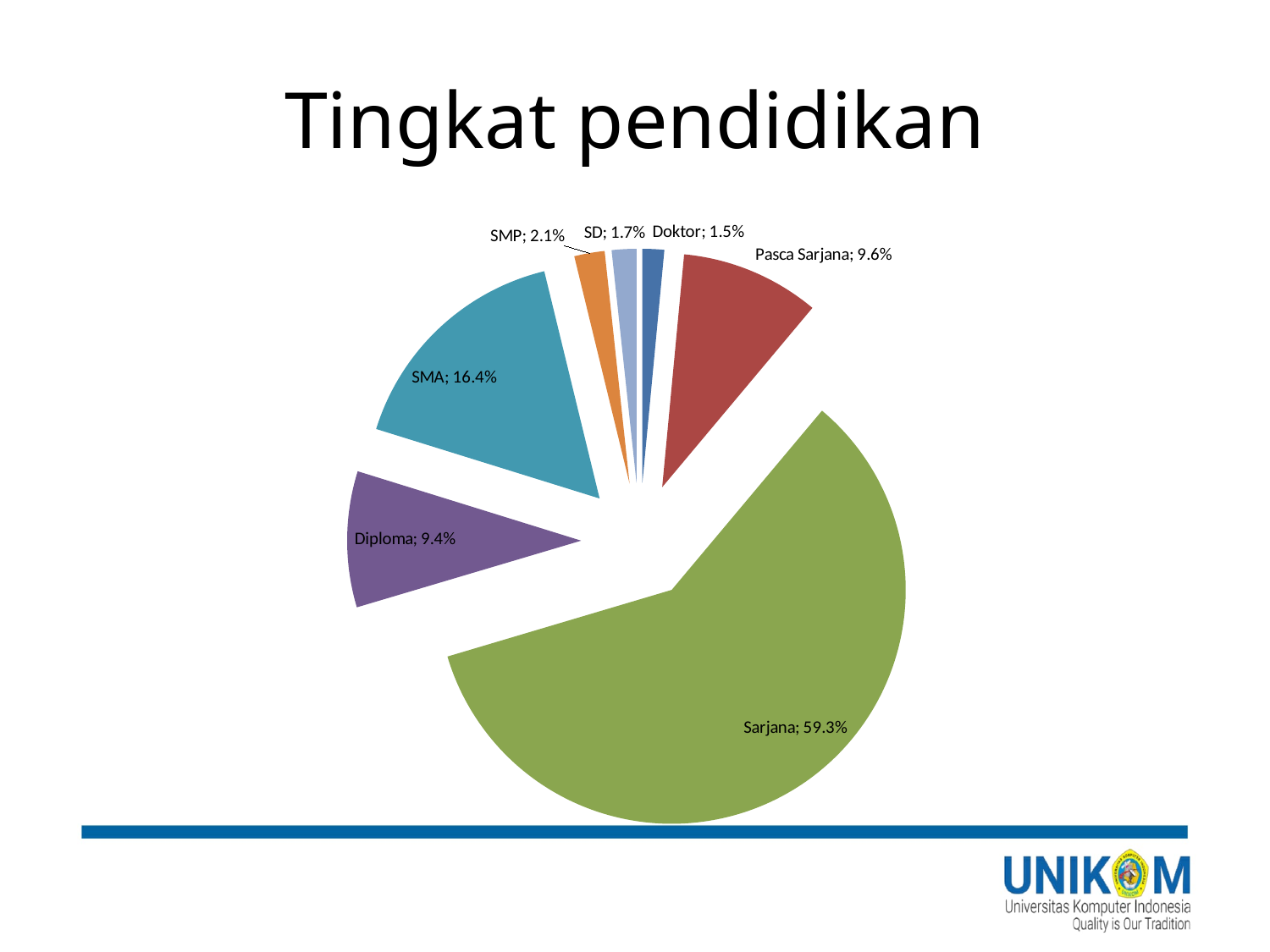
What percentage is shown for SMA? 16.4% What percentage is shown for Doktor? 1.5% What is the difference in percentage points between SMP and SD? 0.4 What percentage is shown for Diploma? 9.4% Which category has the smallest share of the pie? Doktor What is the title of the chart? Tingkat pendidikan Which category has the largest share of the pie? Sarjana What is the difference in percentage points between SMA and Diploma? 7.0 How many categories are shown in the pie chart? 7 What kind of chart is shown on the slide? pie chart What percentage is shown for Sarjana? 59.3% Which is larger, the share for Pasca Sarjana or the share for Diploma? Pasca Sarjana